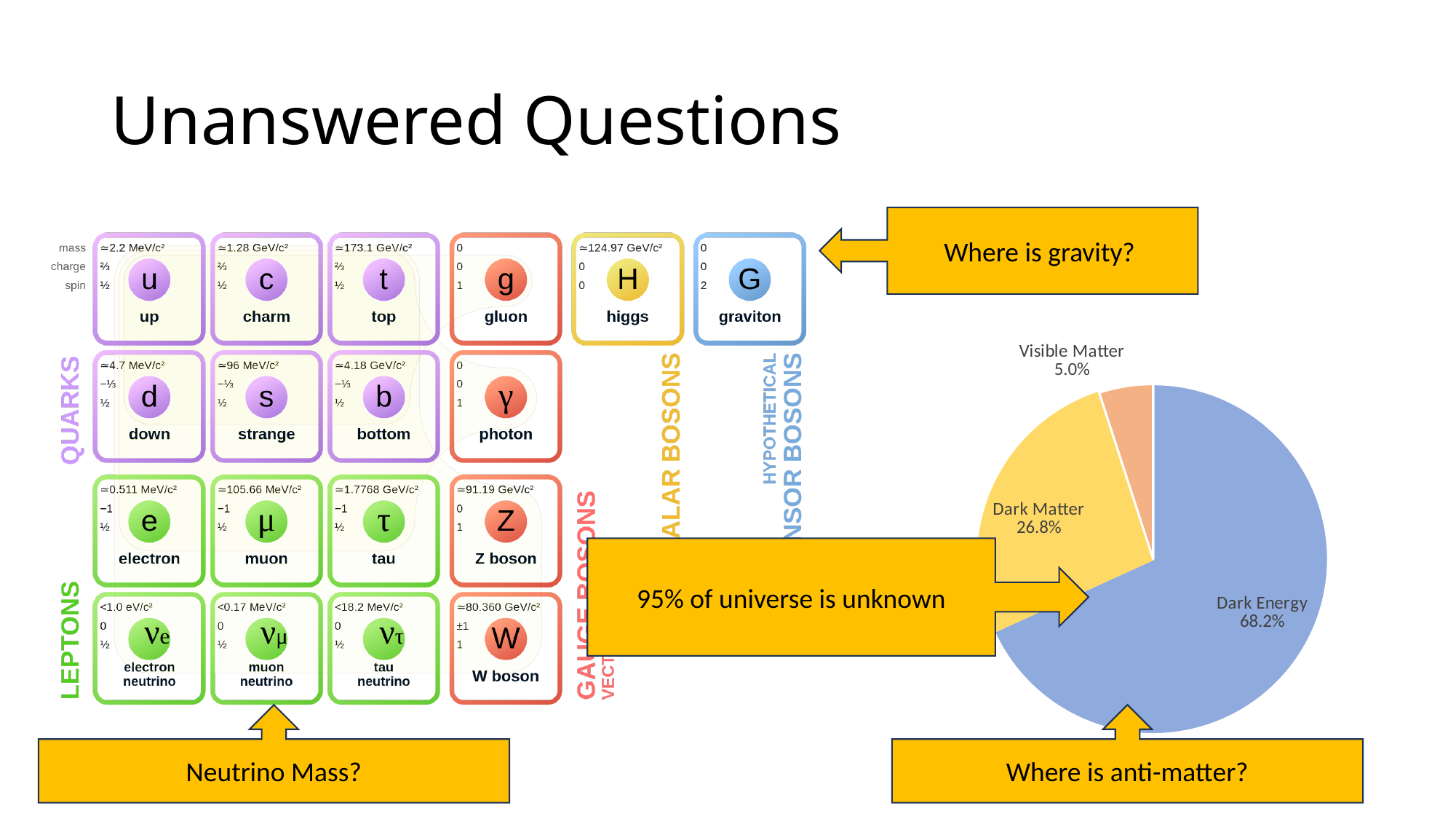
In the pie chart, what share of the universe is Visible Matter? 5.0% How many slices does the pie chart have? 3 In the pie chart, what is the difference between the Dark Matter share and the Visible Matter share? 21.8% In the pie chart, what is the difference between the Dark Energy share and the Dark Matter share? 41.4% In the pie chart, what share of the universe is Dark Energy? 68.2% Which slice of the pie chart is the largest? Dark Energy What colour is the Dark Energy slice in the pie chart? blue In the pie chart, what is the combined share of Dark Energy and Dark Matter? 95.0% What kind of chart is shown on the right side of the slide? pie chart In the pie chart, what share of the universe is Dark Matter? 26.8% Which slice of the pie chart is the smallest? Visible Matter In the pie chart, which is larger: Dark Matter or Visible Matter? Dark Matter